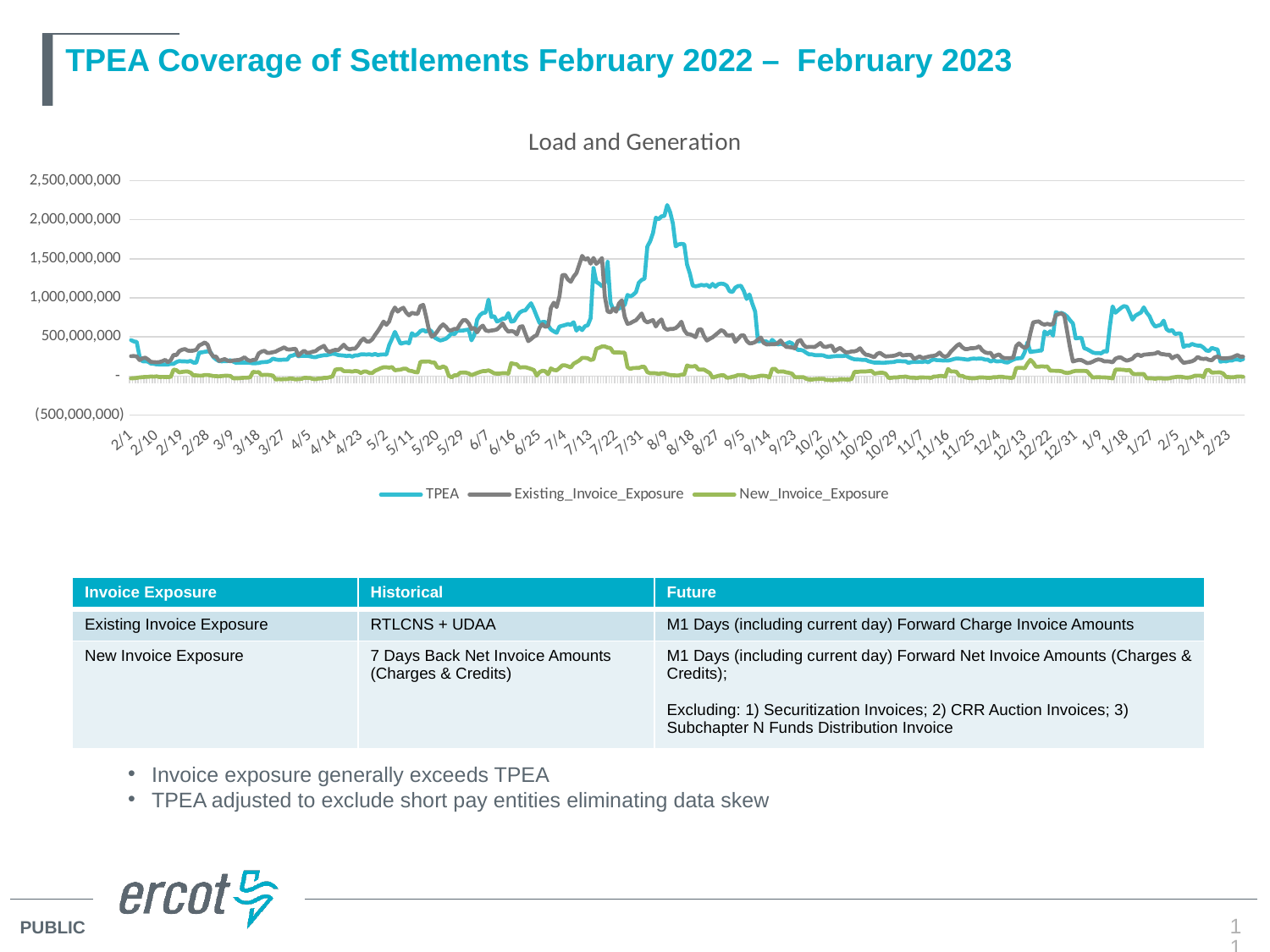
Is the highest value of New_Invoice_Exposure greater or less than 500,000,000? less Does the TPEA line rise or fall between 8/9 and 9/23? Fall Is the peak value of TPEA (around 8/9) greater or less than 2,000,000,000? greater Around 8/9, which series is larger: TPEA or Existing_Invoice_Exposure? TPEA Around 7/4, which series is larger: Existing_Invoice_Exposure or TPEA? Existing_Invoice_Exposure Which series stays lowest across the whole period on the chart? New_Invoice_Exposure Which series is drawn in green in the chart? New_Invoice_Exposure Is the peak value of Existing_Invoice_Exposure (around 7/13) greater or less than 1,000,000,000? greater How many series does the chart legend list? 3 What is the title of the chart? Load and Generation Which series reaches the highest peak on the chart? TPEA What kind of chart is shown on the slide? Line chart